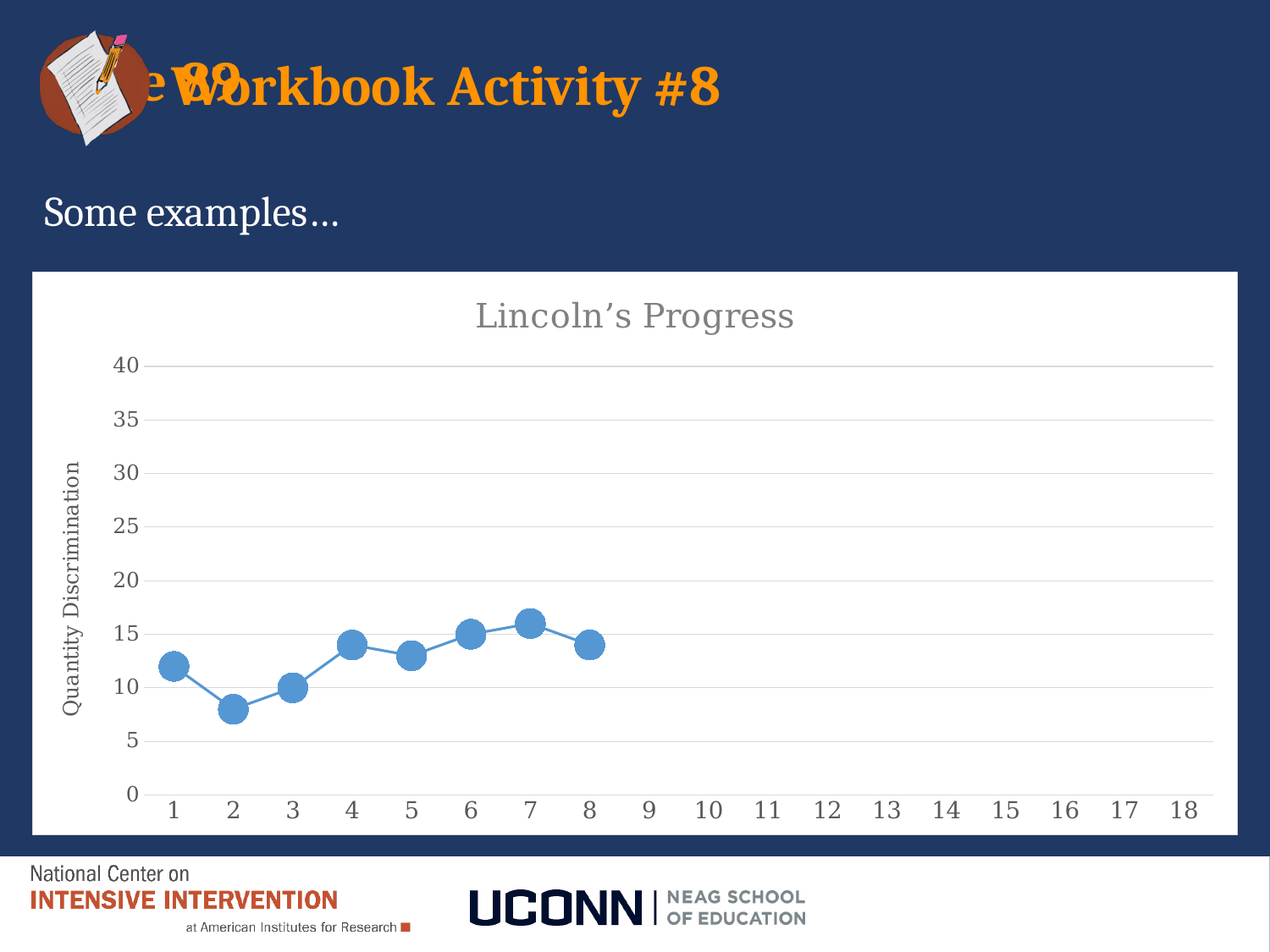
At which x-axis point is the plotted value lowest? 2 Which has the larger value, point 4 or point 2? point 4 What is the label on the vertical axis of the chart? Quantity Discrimination At which x-axis point is the plotted value highest? 7 Do the values rise or fall from point 2 to point 4? rise How many data points are plotted on the line? 8 What is the title of the chart? Lincoln's Progress Is the value at point 2 greater or less than 10? less What type of chart is shown on the slide? line chart Is the value at point 1 greater or less than 10? greater